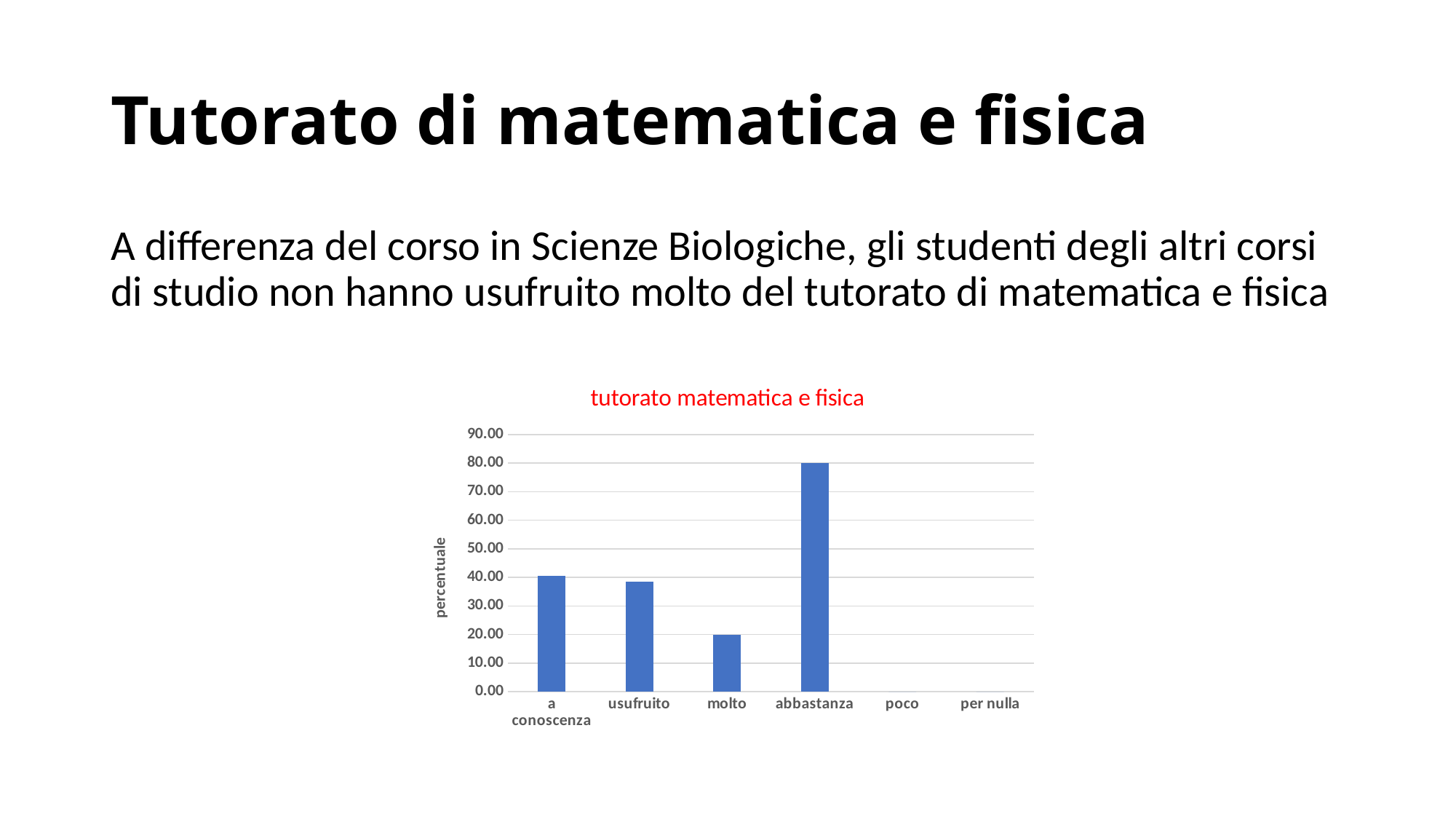
How many categories are shown on the x axis of the chart? 6 What is the value for molto? 20.00 Which category has the highest value in the chart? abbastanza What is the value for abbastanza? 80.00 What is the title of the chart? tutorato matematica e fisica Which is larger, the value for molto or the value for abbastanza? abbastanza What type of chart is shown on the slide? bar chart What is the difference between the values for abbastanza and molto? 60.00 Which is larger, the value for usufruito or the value for molto? usufruito Is the value for a conoscenza greater or less than 30.00? greater What is the label of the y axis? percentuale Is the value for usufruito greater or less than 50.00? less